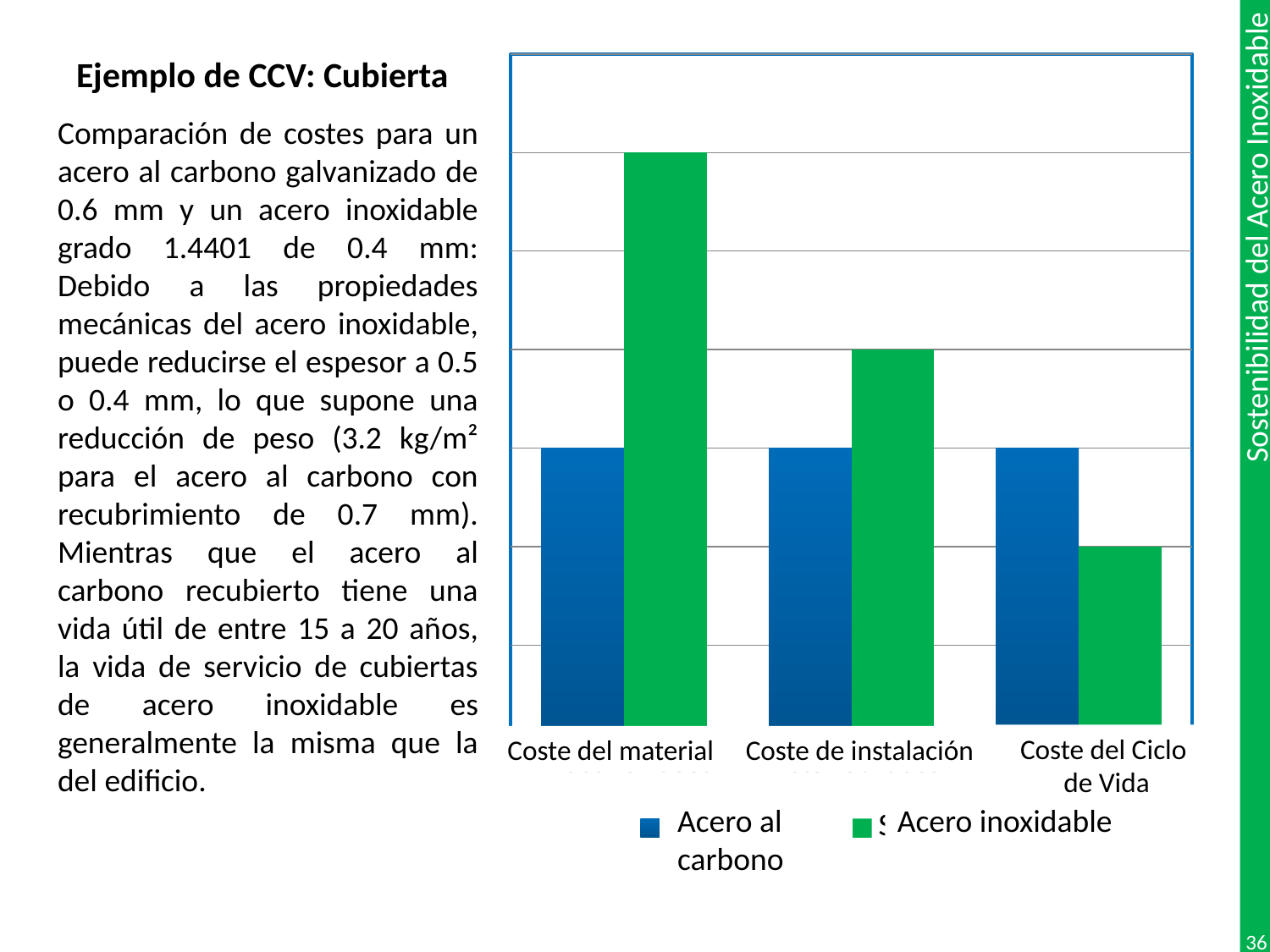
For Coste del Ciclo de Vida, which series has the larger value, Acero al carbono or Acero inoxidable? Acero al carbono For Coste del material, which series has the larger value, Acero al carbono or Acero inoxidable? Acero inoxidable Which is larger, the Acero inoxidable value for Coste del material or the Acero inoxidable value for Coste de instalación? Coste del material How many categories are shown on the x axis of the chart? 3 Which series does the green bar represent in the chart? Acero inoxidable Which series does the blue bar represent in the chart? Acero al carbono For which category is the Acero inoxidable bar the lowest? Coste del Ciclo de Vida For which category is the Acero inoxidable bar the highest? Coste del material How many series does the chart legend list? 2 Do the Acero inoxidable values rise or fall from Coste del material to Coste del Ciclo de Vida? fall What kind of chart is shown on the slide? bar chart